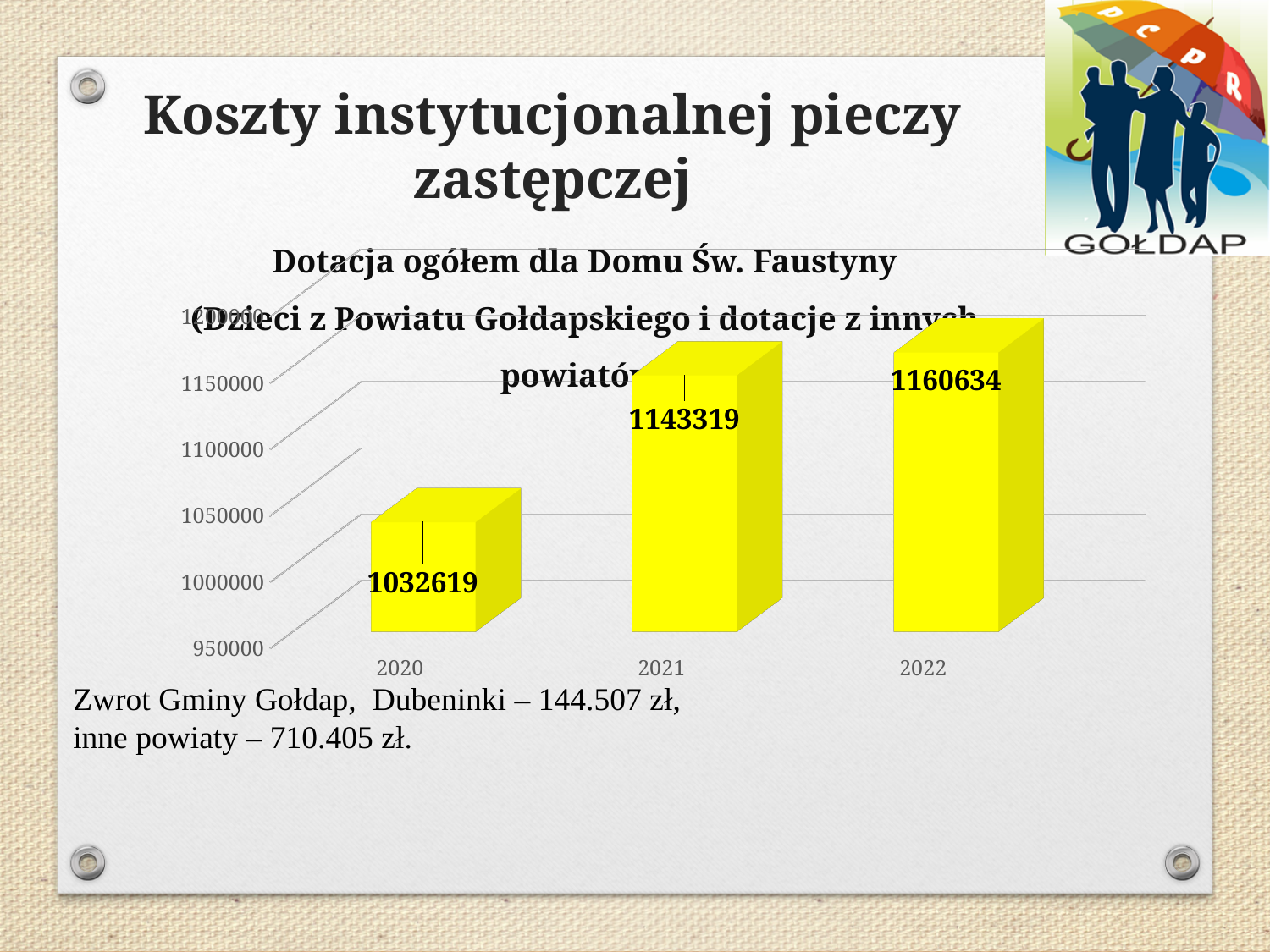
What is the difference between the values for 2022 and 2021? 17315 What is the value for 2021? 1143319 Is the value for 2020 greater or less than 1050000? less Do the values rise or fall from 2020 to 2022? rise What kind of chart is shown on the slide? bar chart Which year has the lowest value? 2020 Which is larger, the value for 2020 or the value for 2021? 2021 What is the value for 2020? 1032619 How many years are shown on the x axis? 3 What is the difference between the values for 2021 and 2020? 110700 What is the value for 2022? 1160634 Which year has the highest value? 2022